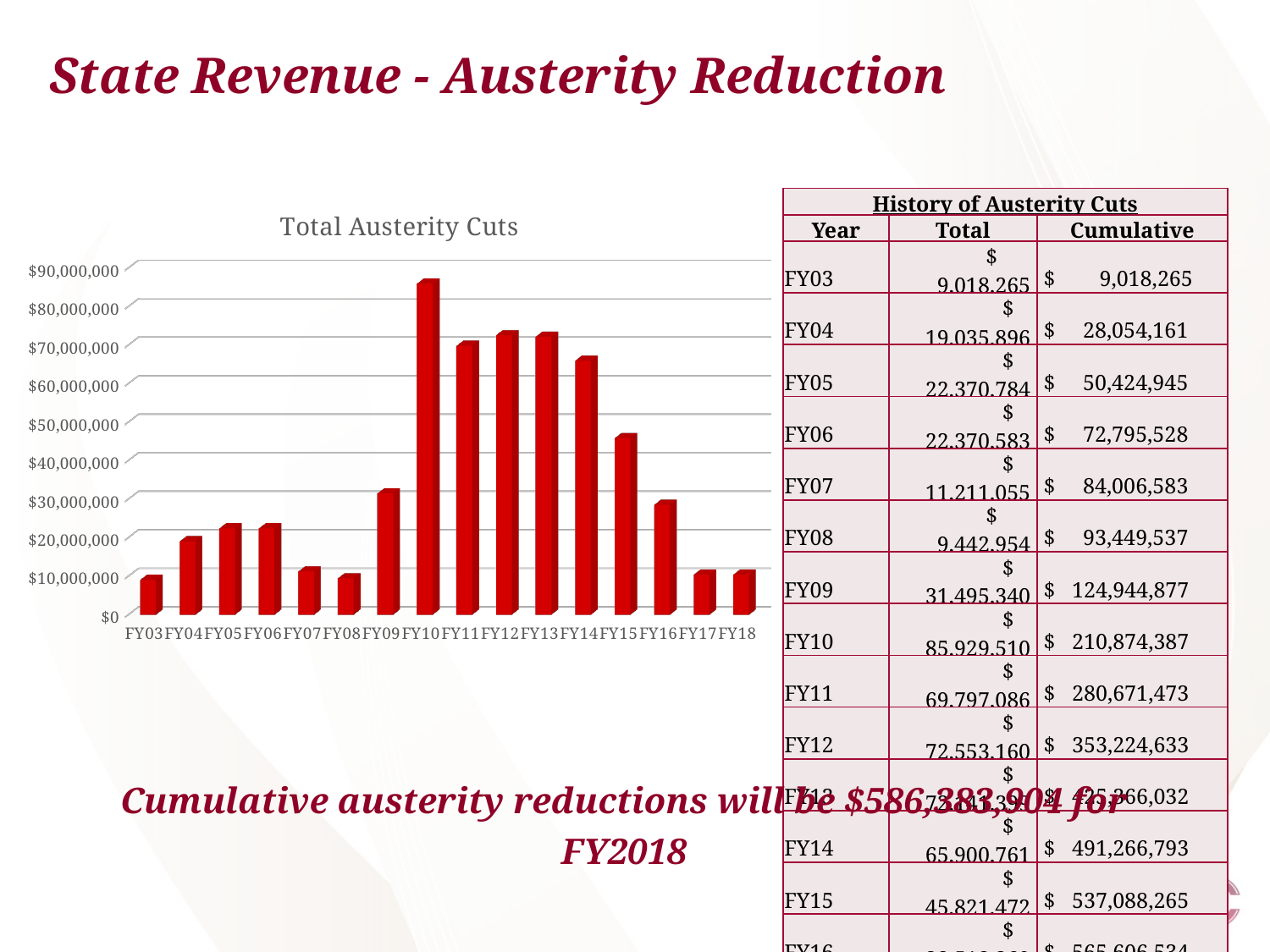
Which fiscal year has the highest total austerity cut in the chart? FY10 Is the value for FY16 greater or less than $20,000,000? greater How many fiscal years are plotted on the x axis of the chart? 16 Is the value for FY15 greater or less than $40,000,000? greater Is the value for FY07 greater or less than $20,000,000? less What is the title of the chart? Total Austerity Cuts What kind of chart is shown on the slide? bar chart Which is larger, the value for FY10 or the value for FY11? FY10 Which is larger, the value for FY09 or the value for FY15? FY15 Do the values generally rise or fall from FY10 to FY18? fall